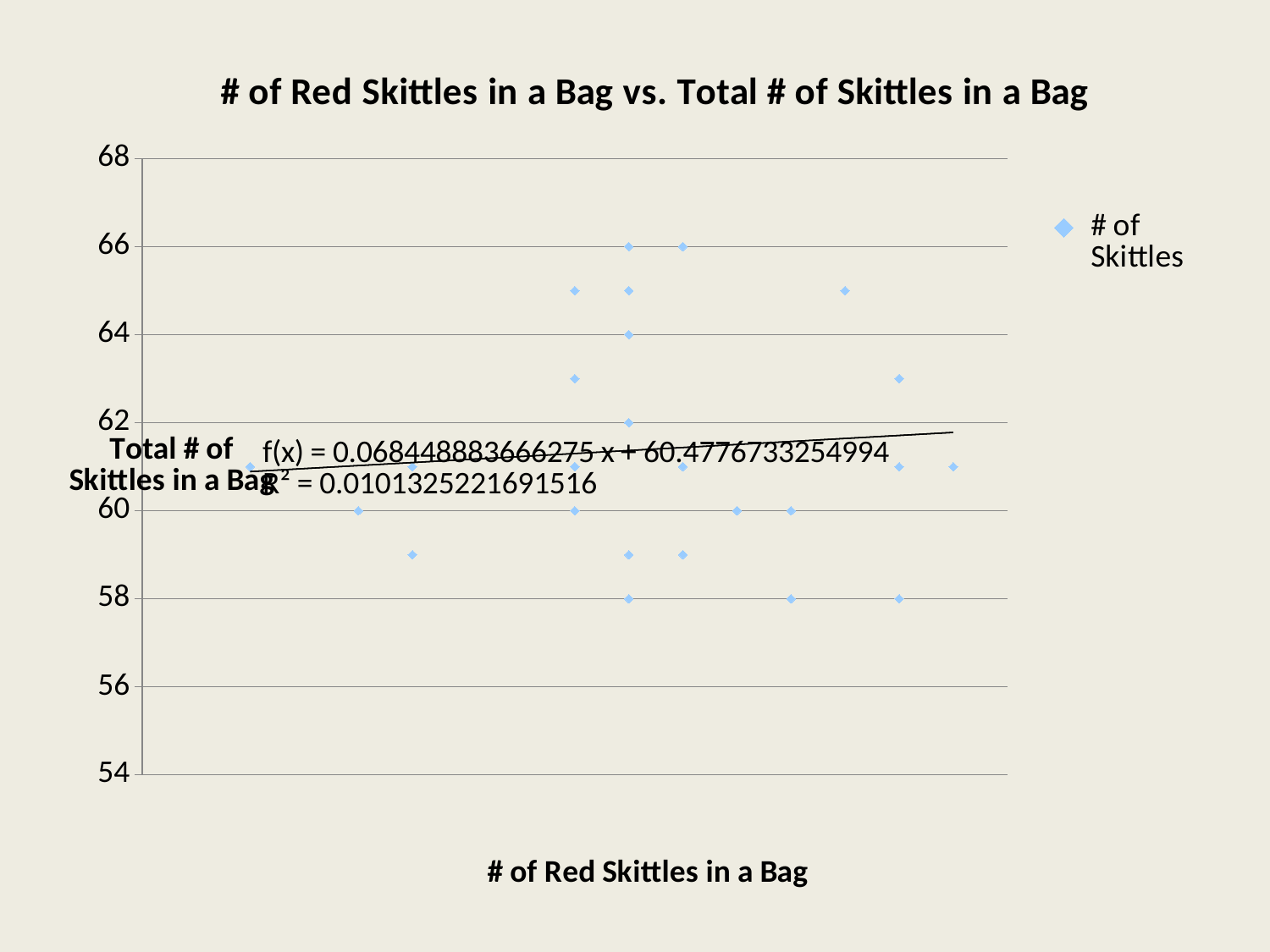
What is the difference between the highest and lowest plotted total # of Skittles values? 8 What is the trendline equation shown on the chart? f(x) = 0.068448883666275 x + 60.4776733254994 What is the highest value shown on the vertical axis? 68 What kind of chart is shown on the slide? scatter chart What is the name of the series shown in the legend? # of Skittles What is the R² value shown on the chart? 0.0101325221691516 What is the lowest value shown on the vertical axis? 54 How many series does the legend list? 1 What is the highest total # of Skittles value plotted on the chart? 66 What is the title of the chart? # of Red Skittles in a Bag vs. Total # of Skittles in a Bag What is the lowest total # of Skittles value plotted on the chart? 58 Does the trendline rise or fall as the # of Red Skittles in a Bag increases? rise